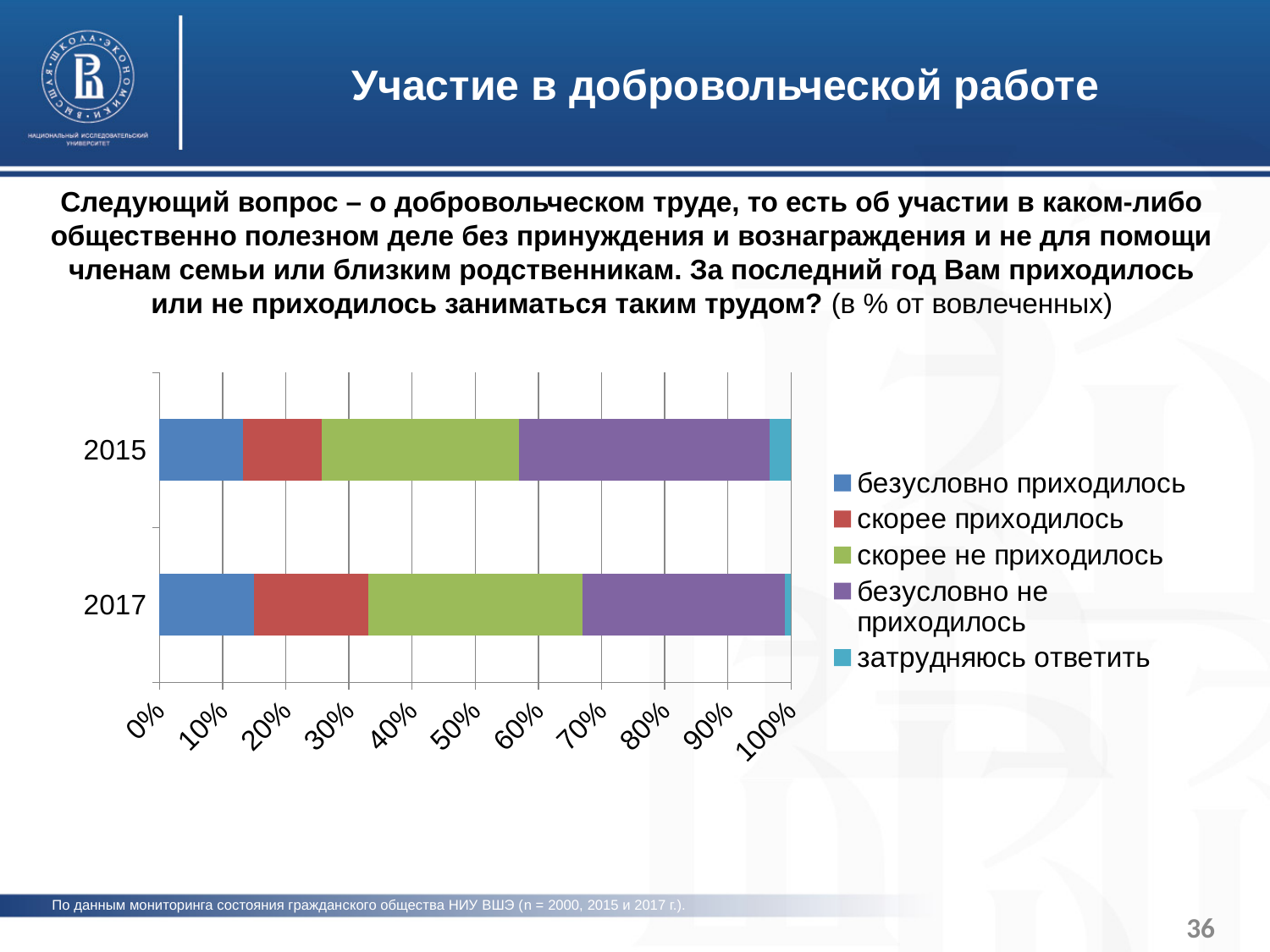
What is the highest value shown on the horizontal axis? 100% Is the share of 'безусловно не приходилось' larger in 2015 or in 2017? 2015 Is the share of 'затрудняюсь ответить' larger in 2015 or in 2017? 2015 Which years are shown as categories on the chart? 2015 and 2017 Which response category is the smallest segment in the 2017 bar? затрудняюсь ответить How many years (categories) are shown on the chart? 2 Which colour represents 'скорее не приходилось' in the legend? green What kind of chart is shown on the slide? stacked bar chart Which response category is the smallest segment in the 2015 bar? затрудняюсь ответить Which response category is the largest segment in the 2015 bar? безусловно не приходилось How many series does the legend list? 5 Is the share of 'скорее приходилось' larger in 2015 or in 2017? 2017